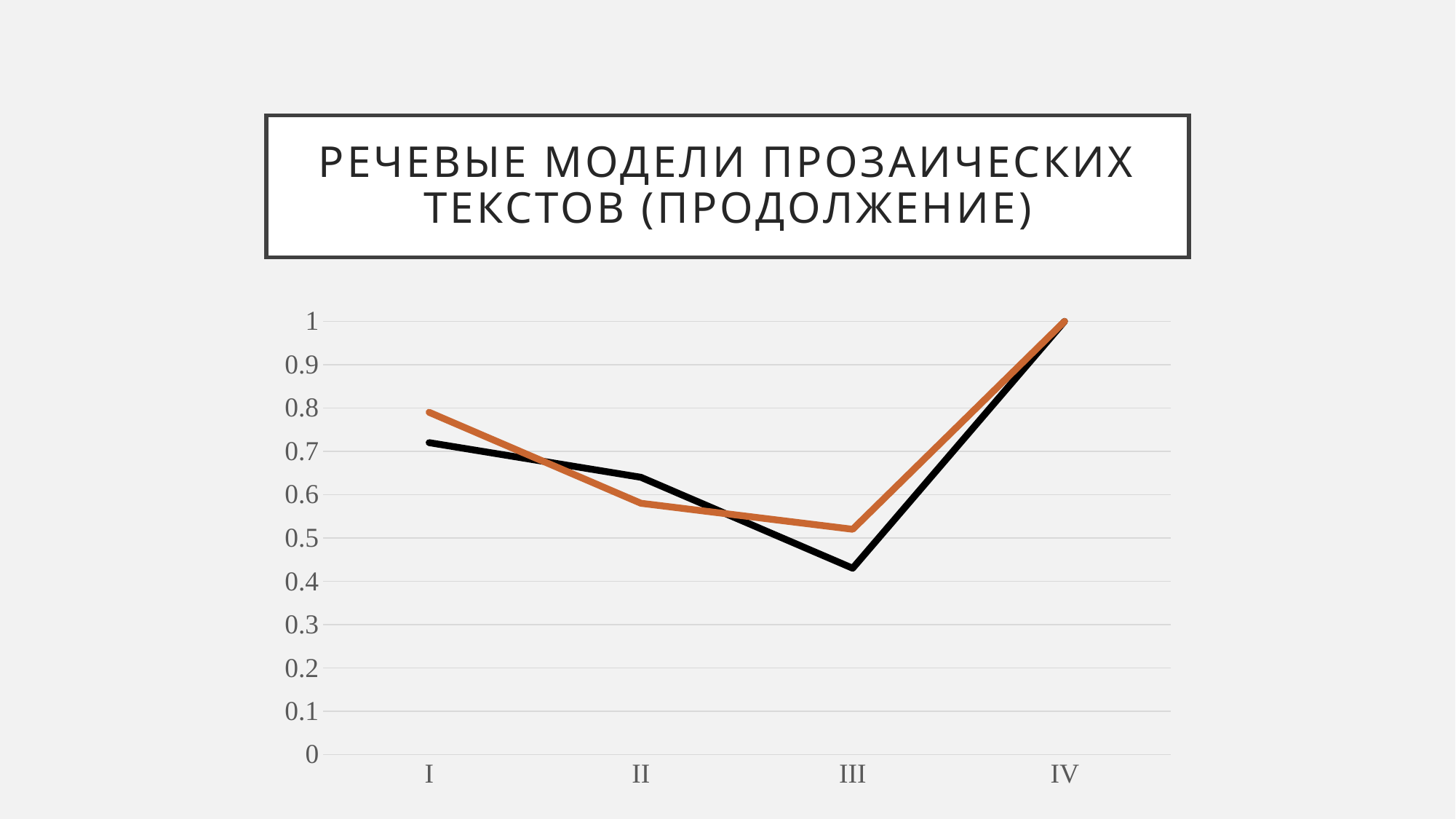
Is the value of the black line at category III greater or less than 0.5? less What is the title of the slide? РЕЧЕВЫЕ МОДЕЛИ ПРОЗАИЧЕСКИХ ТЕКСТОВ (ПРОДОЛЖЕНИЕ) Is the value of the orange line at category I greater or less than 0.7? greater What value does the orange line reach at category IV? 1 How many lines are plotted on the chart? 2 At which category is the black line lowest? III At category III, which line has the higher value, the black line or the orange line? the orange line At which category is the orange line lowest? III What kind of chart is shown on the slide? line chart At which category is the black line highest? IV What value does the black line reach at category IV? 1 How many categories are shown on the x axis? 4